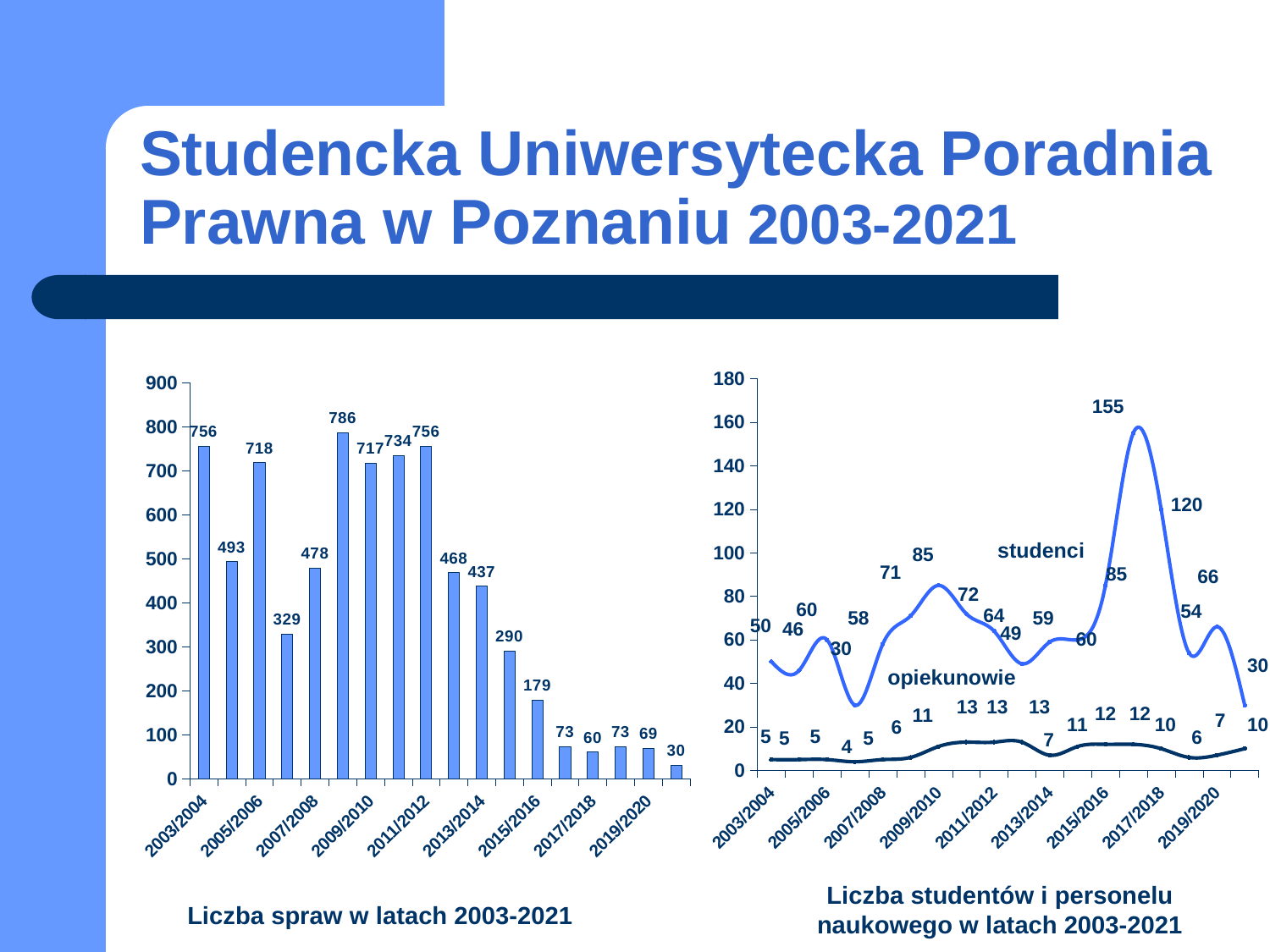
In the left chart 'Liczba spraw w latach 2003-2021', what is the lowest value shown? 30 How many series are plotted in the right chart 'Liczba studentów i personelu naukowego w latach 2003-2021'? 2 What kind of chart is the right chart, 'Liczba studentów i personelu naukowego w latach 2003-2021'? line chart In the left chart 'Liczba spraw w latach 2003-2021', what is the difference between the values for 2003/2004 and 2005/2006? 38 In the left chart 'Liczba spraw w latach 2003-2021', what is the value for 2003/2004? 756 In the right chart 'Liczba studentów i personelu naukowego w latach 2003-2021', what is the 'opiekunowie' value for 2017/2018? 10 In the right chart 'Liczba studentów i personelu naukowego w latach 2003-2021', what is the 'studenci' value for 2009/2010? 85 What kind of chart is the left chart, 'Liczba spraw w latach 2003-2021'? bar chart How many bars are plotted in the left chart 'Liczba spraw w latach 2003-2021'? 18 In the left chart 'Liczba spraw w latach 2003-2021', what is the highest value shown? 786 In the right chart 'Liczba studentów i personelu naukowego w latach 2003-2021', what is the highest value of the 'studenci' series? 155 In the right chart 'Liczba studentów i personelu naukowego w latach 2003-2021', which series has the larger value for 2015/2016, 'studenci' or 'opiekunowie'? studenci